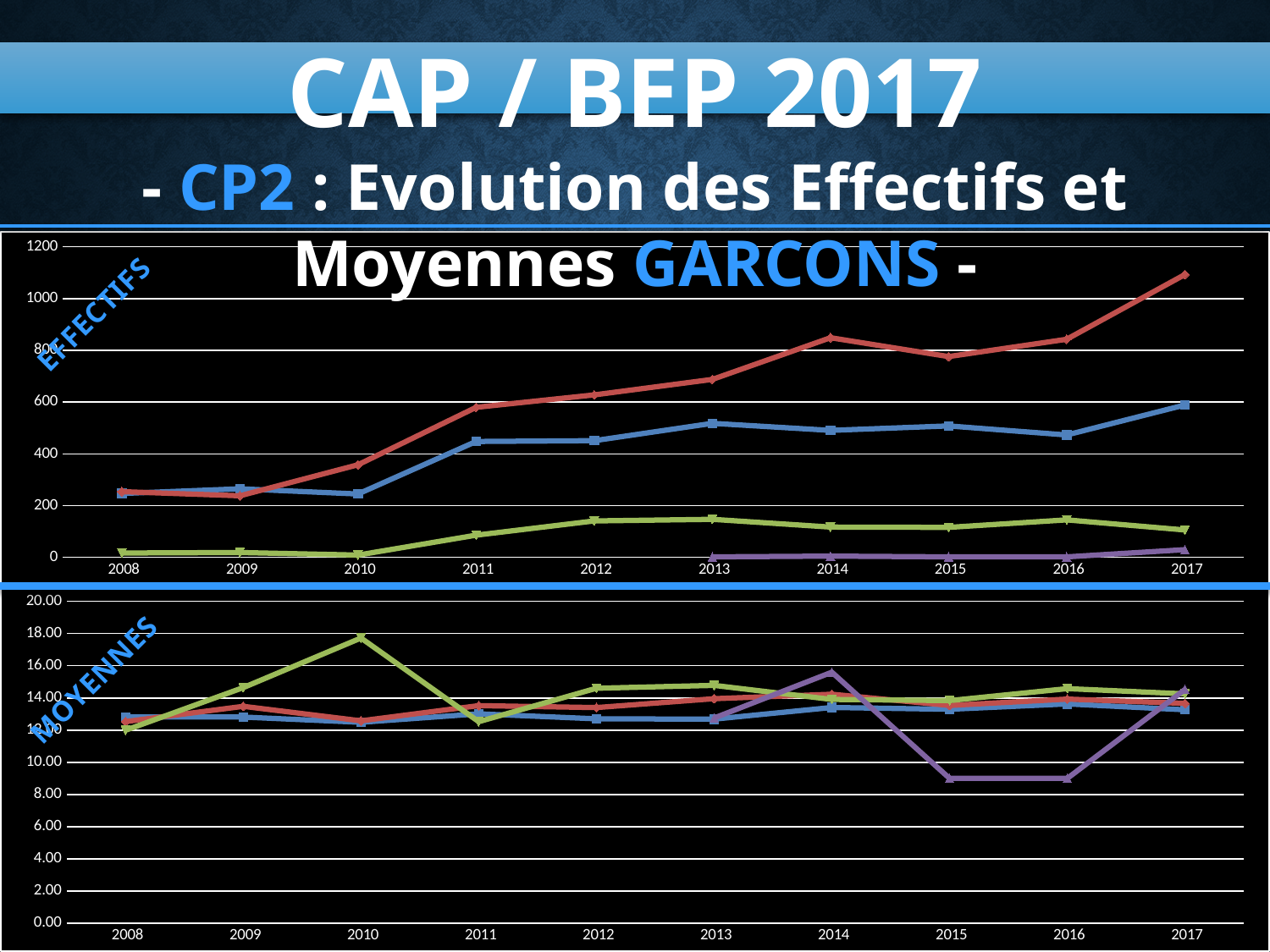
In the top chart (EFFECTIFS), does the red line generally rise or fall from 2008 to 2017? rise In the top chart (EFFECTIFS), is the value of the red line in 2017 greater or less than 1000? greater In the top chart (EFFECTIFS), is the value of the red line in 2011 greater or less than 400? greater In the top chart (EFFECTIFS), which is larger in 2017, the red line or the blue line? the red line In the top chart (EFFECTIFS), is the value of the green line in 2017 greater or less than 200? less What kind of chart is the top chart labelled EFFECTIFS? line chart How many years are shown on the x axis of the top chart (EFFECTIFS)? 10 In the bottom chart (MOYENNES), in which year does the green line reach its highest value? 2010 How many charts are shown on the slide? 2 In the top chart (EFFECTIFS), in which year does the red line reach its highest value? 2017